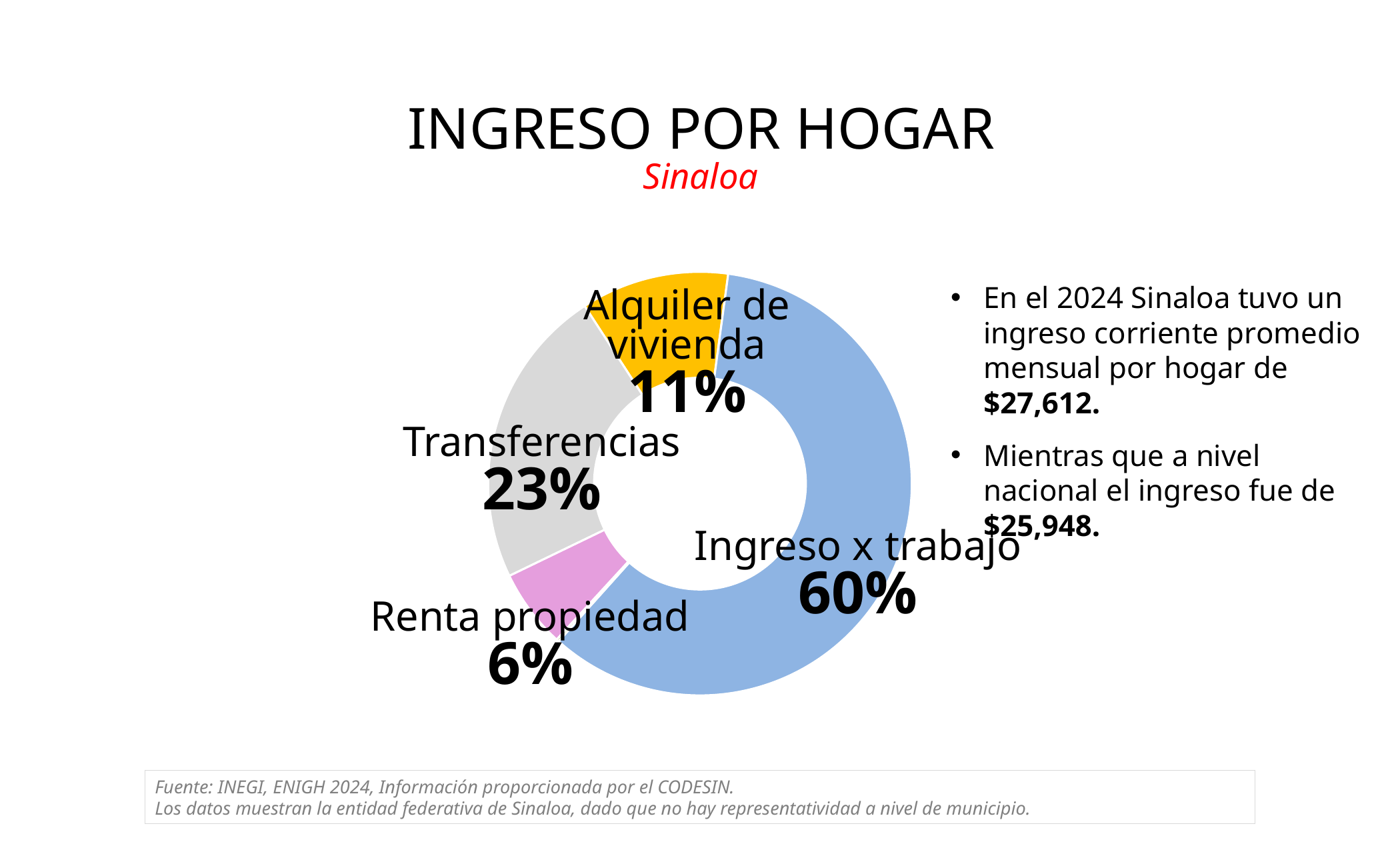
What share of household income does Alquiler de vivienda represent? 11% What kind of chart is shown on the slide? Doughnut (pie) chart Which category has the largest share of household income? Ingreso x trabajo Which category has the smallest share of household income? Renta propiedad What share of household income does Renta propiedad represent? 6% What share of household income does Ingreso x trabajo represent? 60% What share of household income does Transferencias represent? 23% How many categories are shown in the chart? 4 What is the difference in percentage points between Ingreso x trabajo and Transferencias? 37 Which is larger, the share for Transferencias or the share for Alquiler de vivienda? Transferencias What colour is the Ingreso x trabajo segment? Blue What is the combined share of Alquiler de vivienda and Renta propiedad? 17%